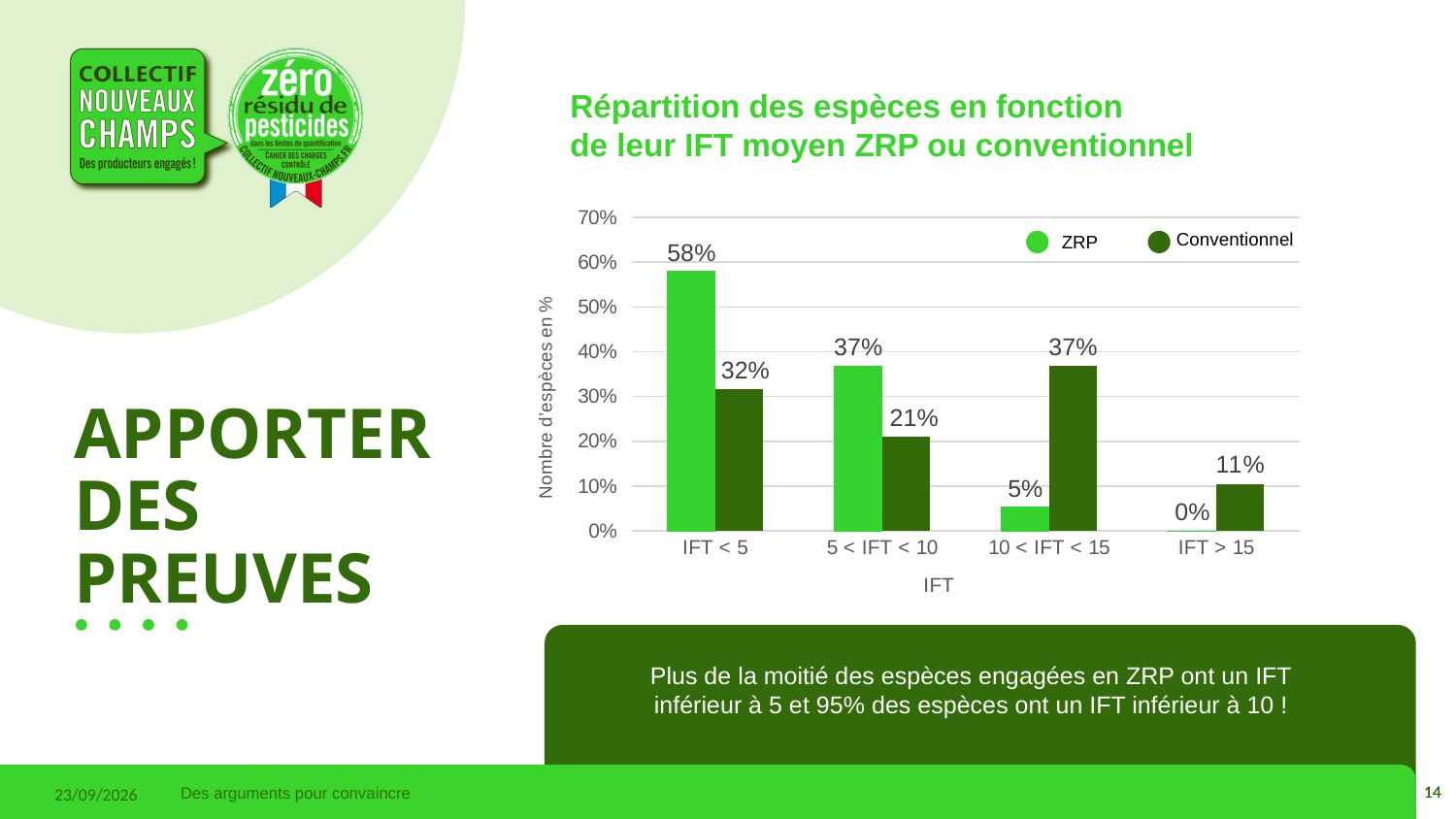
How many series does the legend list? 2 What is the label of the y axis of the chart? Nombre d'espèces en % What is the ZRP value for the IFT > 15 category? 0% What is the Conventionnel value for the 10 < IFT < 15 category? 37% What is the difference between the ZRP and Conventionnel values for the IFT < 5 category? 26% Do the ZRP values rise or fall from IFT < 5 to IFT > 15? Fall Which category has the highest ZRP value? IFT < 5 What is the ZRP value for the IFT < 5 category? 58% Which category has the lowest Conventionnel value? IFT > 15 What kind of chart is shown on the slide? Bar chart For the 10 < IFT < 15 category, which series has the larger value, ZRP or Conventionnel? Conventionnel How many IFT categories are shown on the x axis? 4